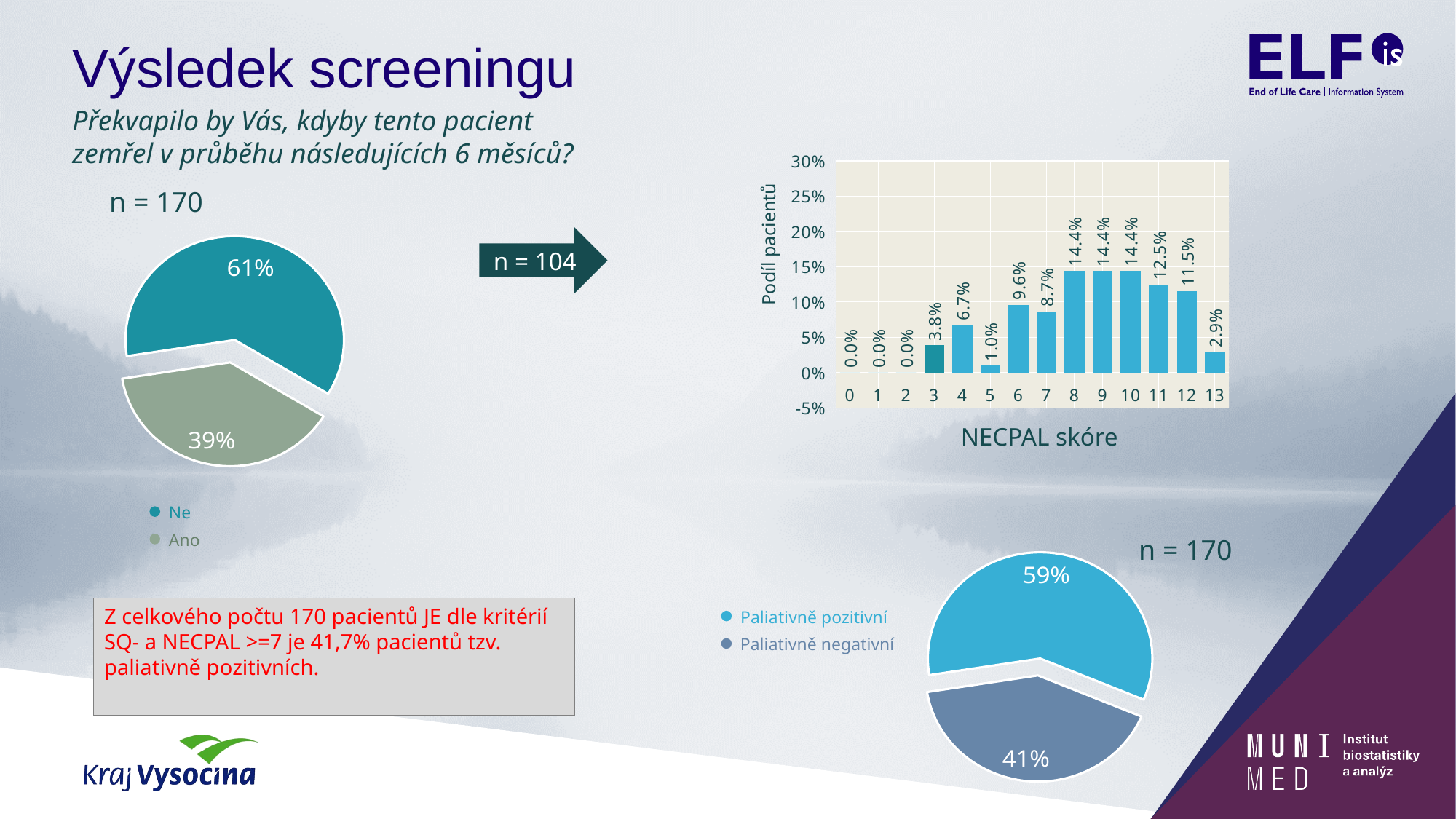
In the left pie chart (n = 170), what share is labelled Ne? 61% How many entries does the legend of the bottom-right pie chart list? 2 What kind of chart is the NECPAL skóre chart? bar chart In the NECPAL skóre bar chart, how many score categories are shown on the x axis? 14 In the NECPAL skóre bar chart, what is the value for score 6? 9.6% In the left pie chart (n = 170), which slice is larger, Ne or Ano? Ne In the NECPAL skóre bar chart, what is the value for score 3? 3.8% In the NECPAL skóre bar chart, how many scores have a value of 0.0%? 3 In the bottom-right pie chart, what share is Paliativně negativní? 41% In the NECPAL skóre bar chart, what is the difference between the values for score 11 and score 13? 9.6% In the NECPAL skóre bar chart, what is the value for score 12? 11.5% In the NECPAL skóre bar chart, which is larger, the value for score 4 or the value for score 7? score 7